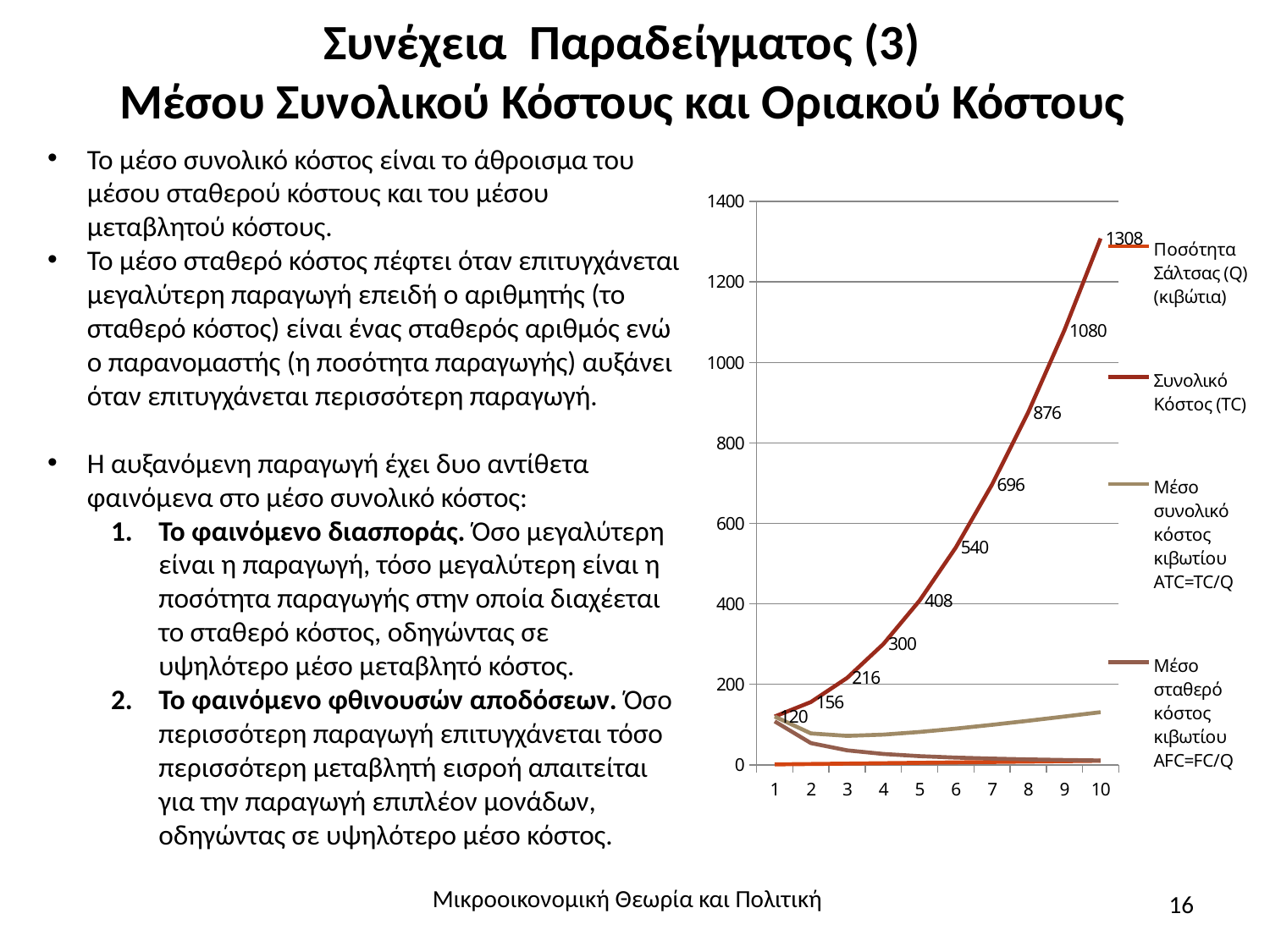
What kind of chart is shown on the slide? line chart What is the value of Συνολικό Κόστος (TC) at quantity 5? 408 How many series does the legend list? 4 What is the difference between Συνολικό Κόστος (TC) at quantity 10 and at quantity 9? 228 At which quantity is Συνολικό Κόστος (TC) highest? 10 Does Συνολικό Κόστος (TC) rise or fall as quantity increases from 1 to 10? rise Which is larger, Συνολικό Κόστος (TC) at quantity 7 or at quantity 6? quantity 7 What is the value of Συνολικό Κόστος (TC) at quantity 10? 1308 How many quantity points are shown on the x axis? 10 At which quantity is Συνολικό Κόστος (TC) lowest? 1 What is the value of Συνολικό Κόστος (TC) at quantity 1? 120 Is the value of Μέσο συνολικό κόστος κιβωτίου ATC=TC/Q at quantity 10 greater or less than 200? less